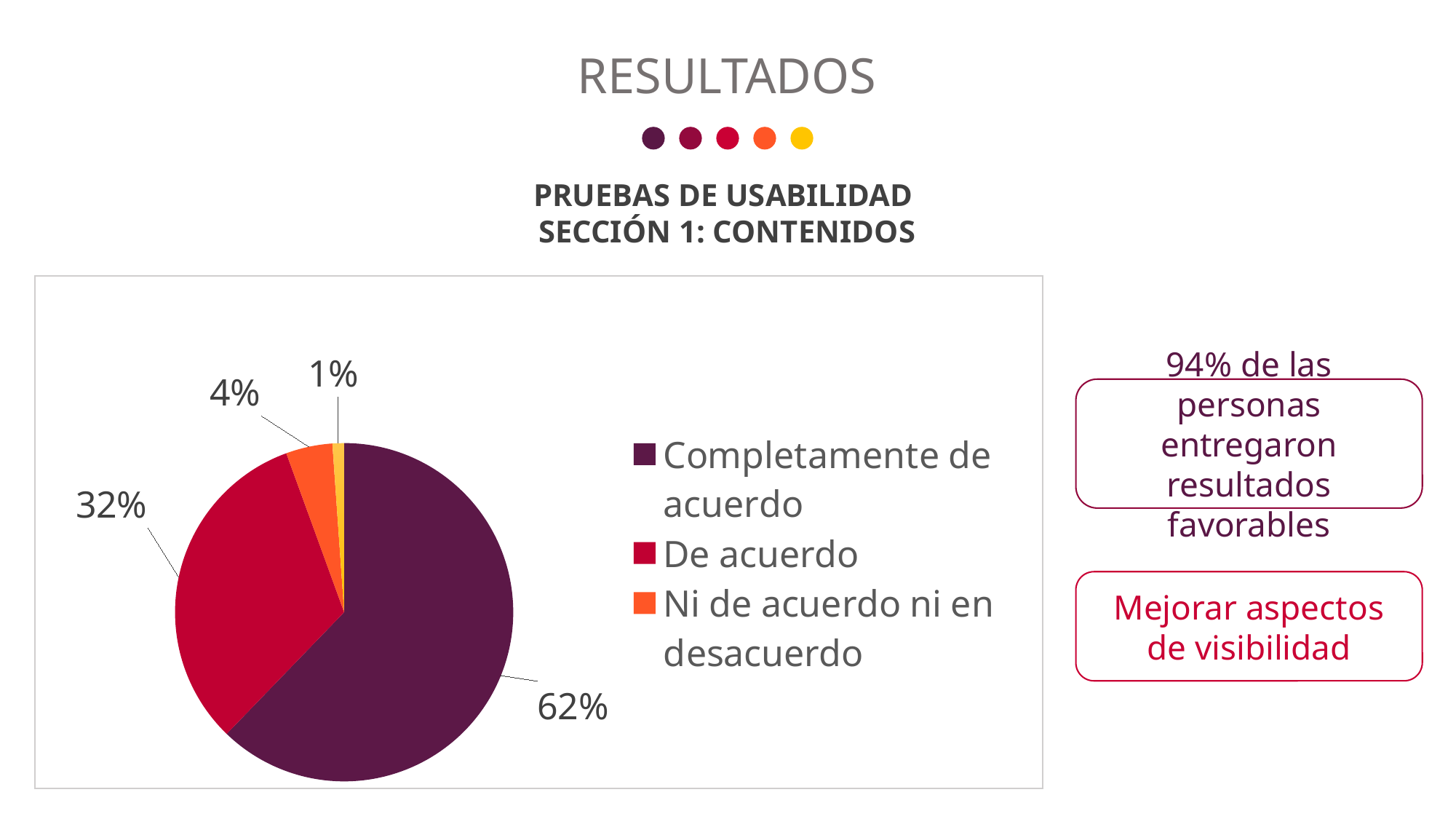
What kind of chart is shown on the slide? Pie chart What percentage of the pie corresponds to "Completamente de acuerdo"? 62% What percentage of the pie corresponds to "Ni de acuerdo ni en desacuerdo"? 4% What colour is the slice for "Ni de acuerdo ni en desacuerdo"? Orange How many entries does the legend list? 3 How many slices with data labels does the pie chart have? 4 What percentage of the pie corresponds to "De acuerdo"? 32% What is the difference in percentage points between "Completamente de acuerdo" and "De acuerdo"? 30 Which category has the largest slice of the pie? Completamente de acuerdo What is the combined share of "Completamente de acuerdo" and "De acuerdo"? 94% Which is larger, the slice for "De acuerdo" or the slice for "Ni de acuerdo ni en desacuerdo"? De acuerdo Which of the legend categories has the smallest slice of the pie? Ni de acuerdo ni en desacuerdo